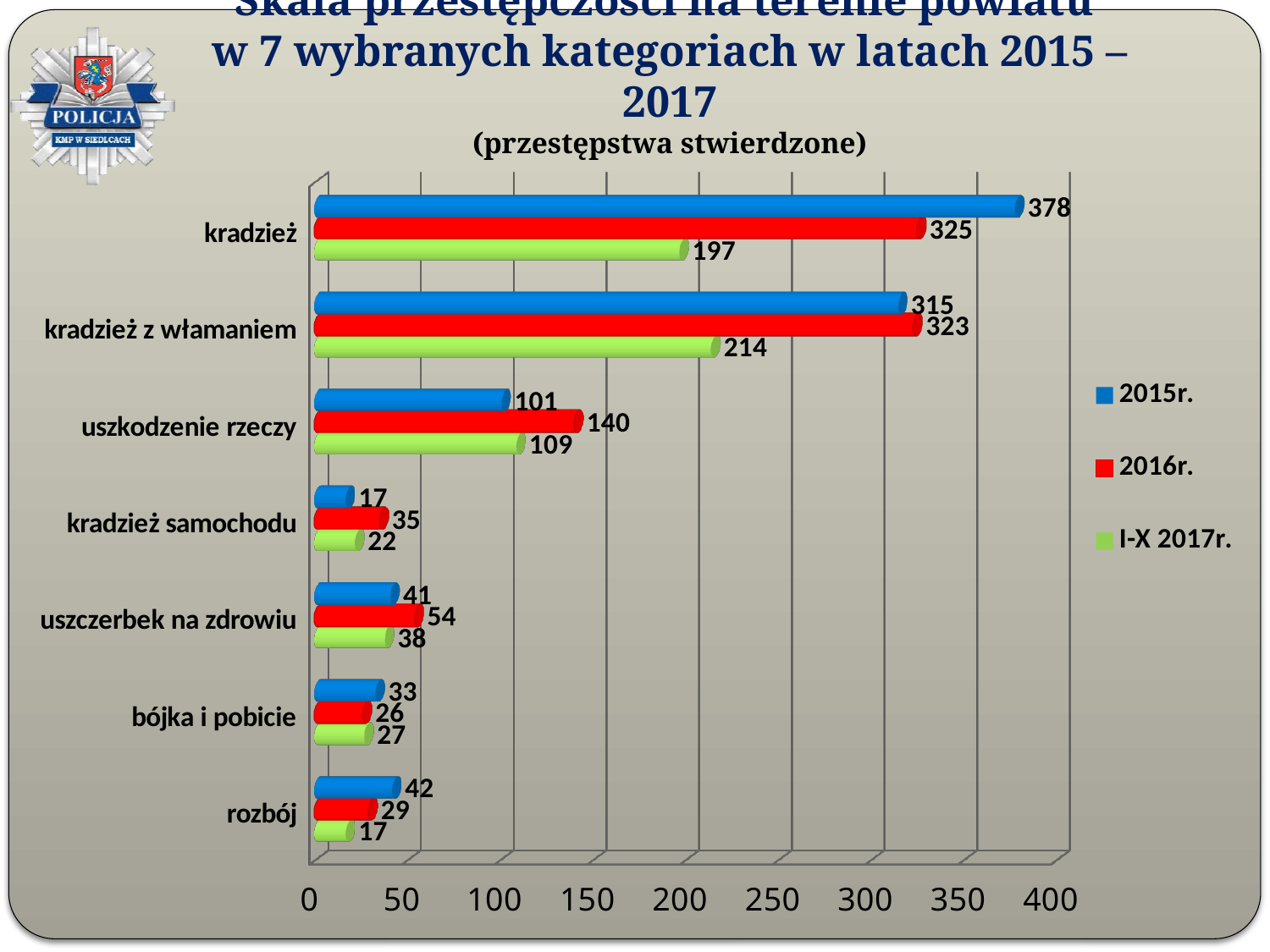
What is the difference between the 2015r. and 2016r. values for kradzież? 53 Which is larger for kradzież z włamaniem: the 2015r. value or the 2016r. value? 2016r. How many categories are shown on the chart? 7 How many series does the legend list? 3 Which colour represents the 2016r. series in the legend? red What is the value for kradzież in the 2015r. series? 378 What is the value for kradzież z włamaniem in the I-X 2017r. series? 214 Which category has the lowest value in the 2016r. series? bójka i pobicie What kind of chart is shown on the slide? bar chart What is the value for uszkodzenie rzeczy in the 2016r. series? 140 Which category has the highest value in the 2015r. series? kradzież What is the value for rozbój in the I-X 2017r. series? 17